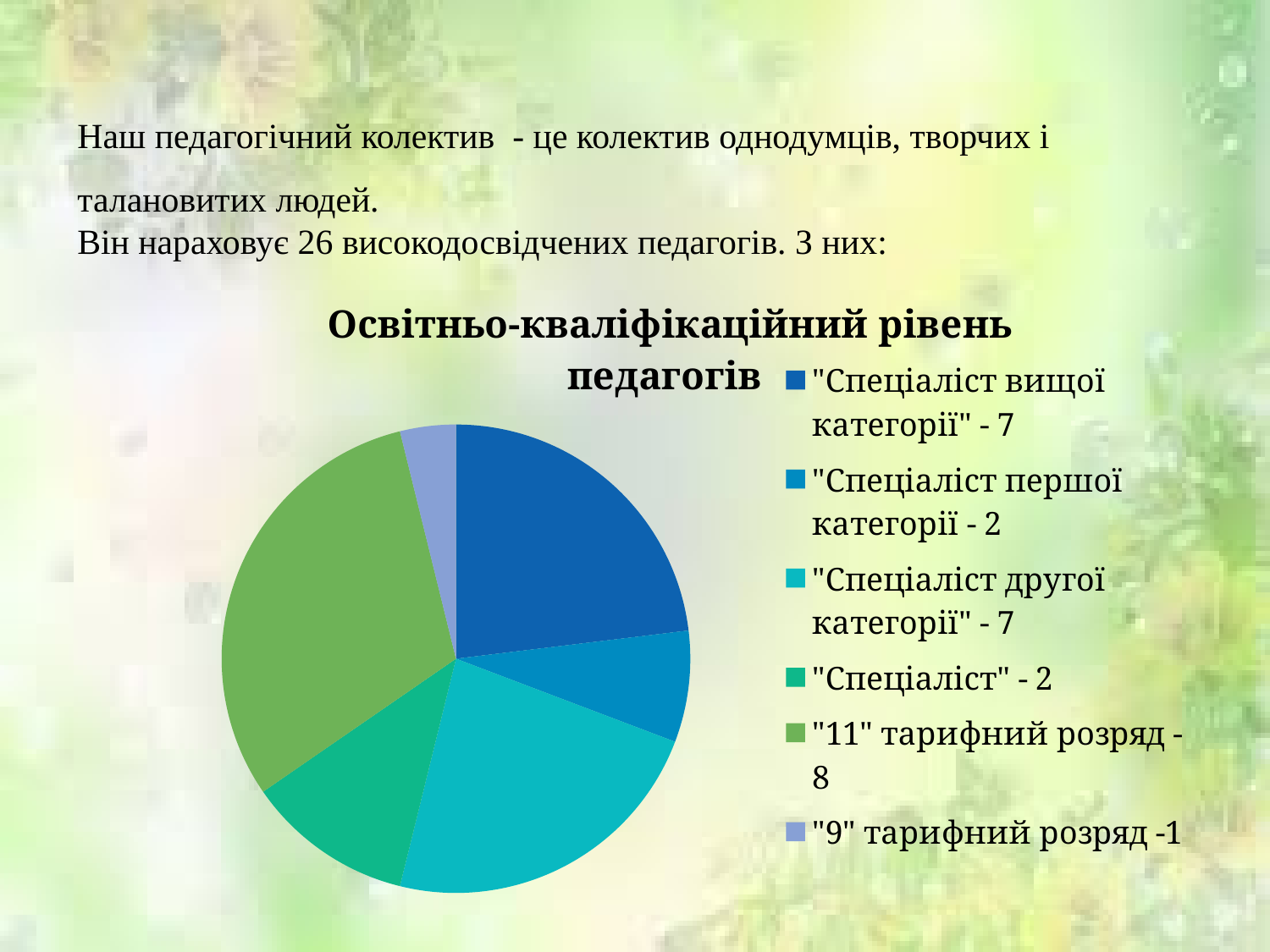
How many teachers are in the "Спеціаліст першої категорії" category? 2 How many slices does the pie chart have? 6 Which category has the largest slice of the pie? "11" тарифний розряд Which is larger: the "Спеціаліст другої категорії" slice or the "Спеціаліст" slice? "Спеціаліст другої категорії" Which category has the smallest slice of the pie? "9" тарифний розряд How many teachers have the "9" тарифний розряд? 1 How many teachers have the "11" тарифний розряд according to the legend? 8 What is the title of the chart? Освітньо-кваліфікаційний рівень педагогів What colour is the slice for "11" тарифний розряд? green What is the difference between the number of teachers with "11" тарифний розряд and those with "9" тарифний розряд? 7 What kind of chart is shown on the slide? pie chart How many teachers are in the "Спеціаліст вищої категорії" category according to the legend? 7